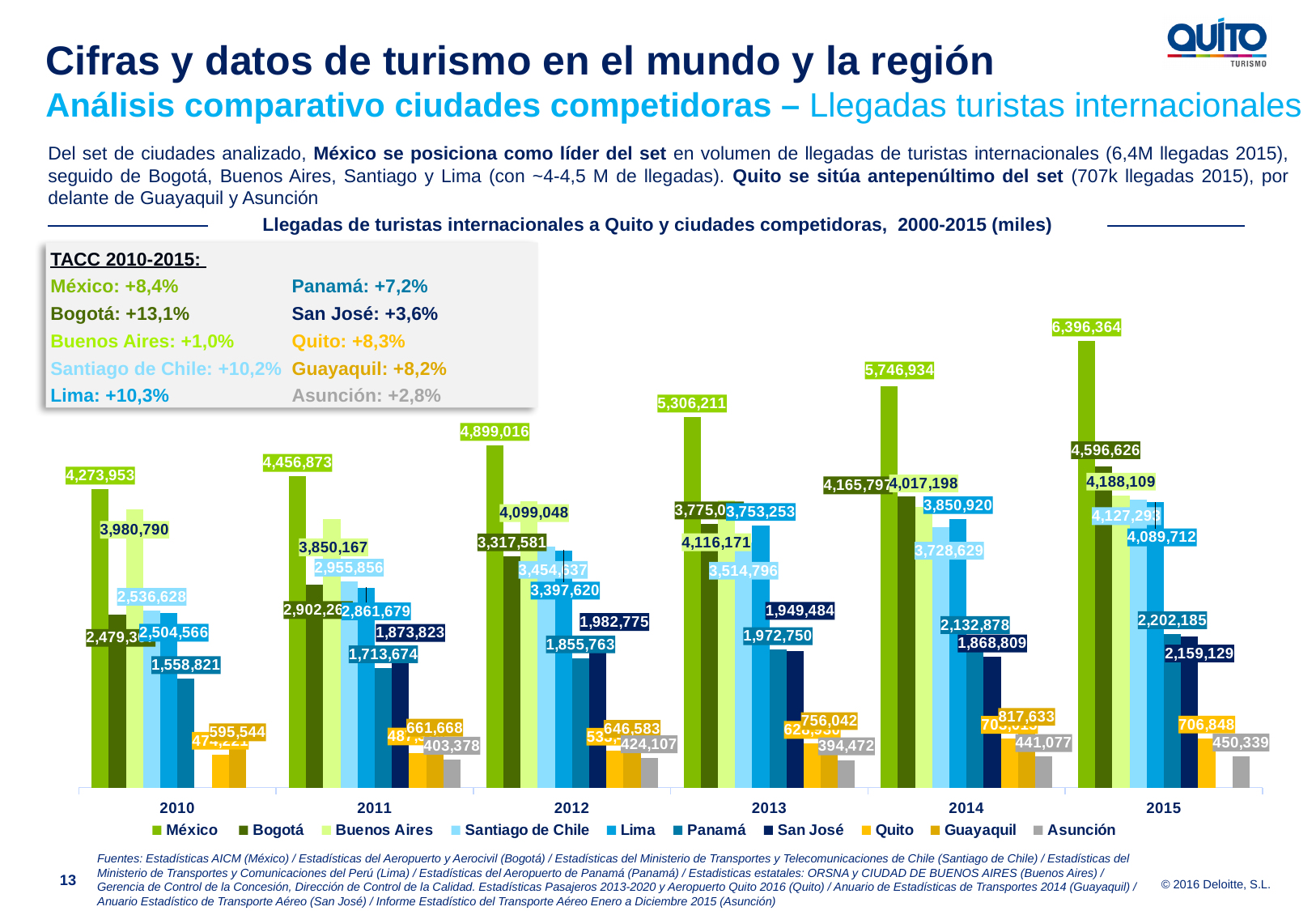
What is the difference between México's values in 2015 and 2014? 649,430 What is the value for Quito in 2015? 706,848 Which city has the lowest value in 2015? Asunción What is the value for Asunción in 2015? 450,339 How many series does the legend list? 10 What kind of chart is shown? Bar chart What is the value for México in 2015? 6,396,364 Which is larger in 2015, Buenos Aires or Lima? Buenos Aires Do the values for México rise or fall from 2010 to 2015? Rise In which year does México have its highest value? 2015 How many years are shown on the x axis? 6 What is the value for Panamá in 2014? 2,132,878